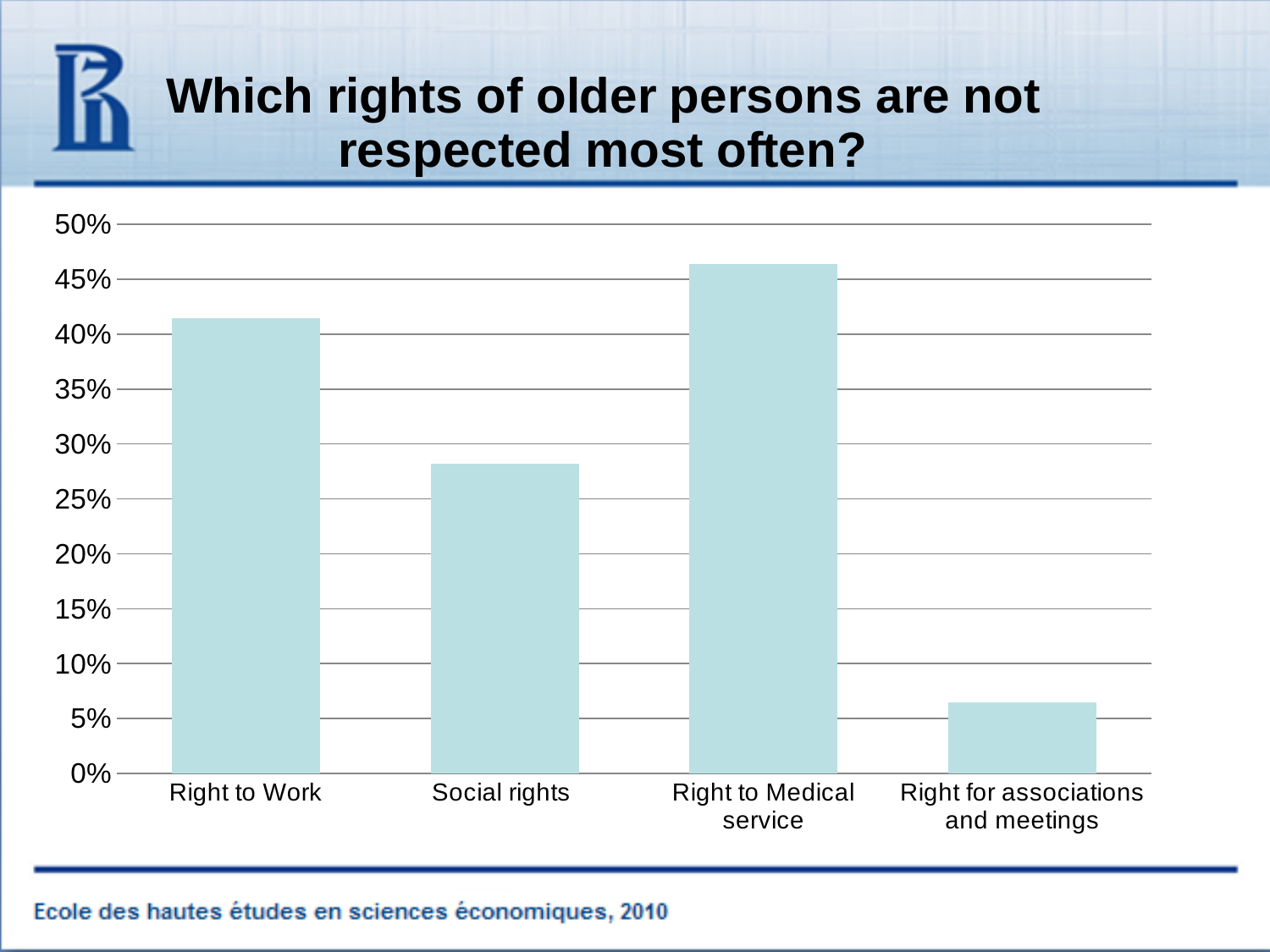
What kind of chart is shown on the slide? bar chart Is the value for Right to Medical service greater or less than 45%? greater Is the value for Right to Work greater or less than 40%? greater Is the value for Social rights greater or less than 30%? less Which category has the lowest value in the chart? Right for associations and meetings What is the title of the slide containing the chart? Which rights of older persons are not respected most often? Which category has the highest value in the chart? Right to Medical service What is the highest value shown on the y axis of the chart? 50% Which is larger, the value for Right to Work or the value for Social rights? Right to Work How many categories are shown on the x axis of the chart? 4 Which is larger, the value for Right to Medical service or the value for Right to Work? Right to Medical service